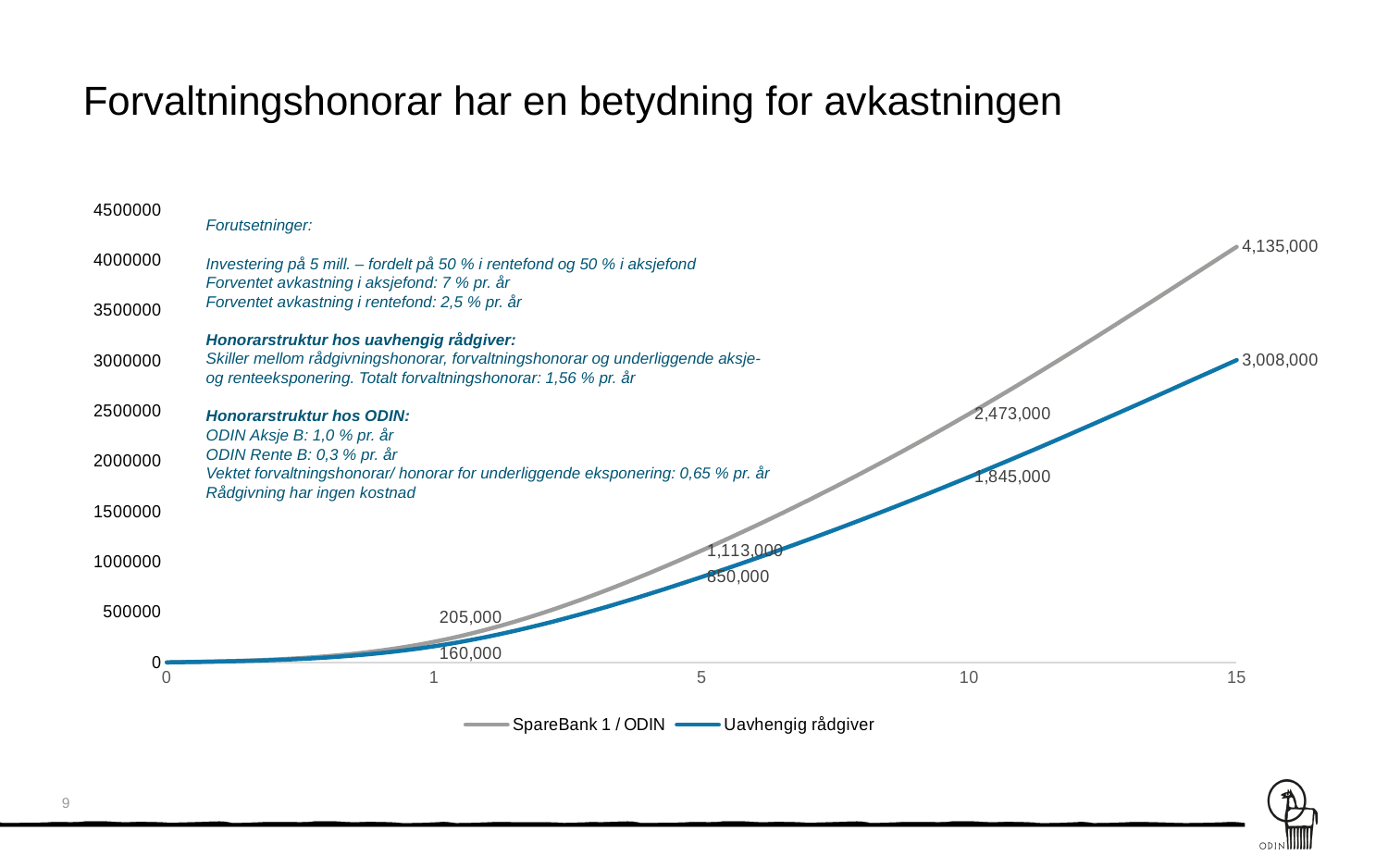
Do the values for Uavhengig rådgiver rise or fall along the x axis? rise What colour is the line for Uavhengig rådgiver? blue Which series has the higher value at x = 5, SpareBank 1 / ODIN or Uavhengig rådgiver? SpareBank 1 / ODIN What is the value for SpareBank 1 / ODIN at x = 10? 2,473,000 What type of chart is shown on the slide? line chart What is the difference between SpareBank 1 / ODIN and Uavhengig rådgiver at x = 15? 1,127,000 How many series does the legend list? 2 What is the value for Uavhengig rådgiver at x = 15? 3,008,000 What is the value for Uavhengig rådgiver at x = 5? 850,000 What is the value for SpareBank 1 / ODIN at x = 1? 205,000 What is the difference between SpareBank 1 / ODIN and Uavhengig rådgiver at x = 10? 628,000 What is the value for SpareBank 1 / ODIN at x = 15? 4,135,000